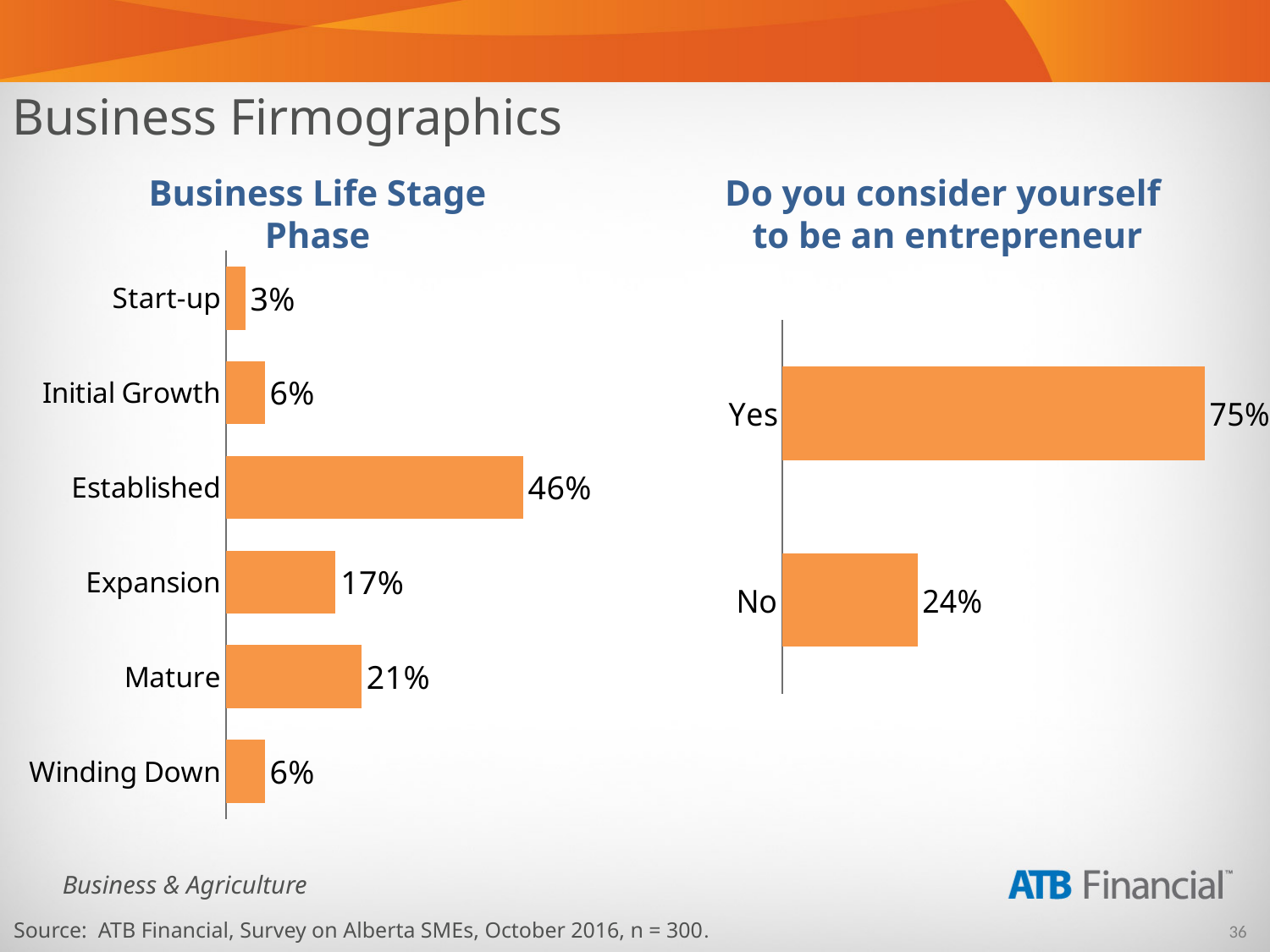
In the 'Business Life Stage Phase' chart, what is the value for Expansion? 17% In the 'Business Life Stage Phase' chart, which is larger, Initial Growth or Mature? Mature In the 'Business Life Stage Phase' chart, what is the difference between Mature and Expansion? 4% In the 'Do you consider yourself to be an entrepreneur' chart, what is the value for No? 24% How many categories are shown in the 'Business Life Stage Phase' chart? 6 What kind of chart is the 'Business Life Stage Phase' chart? Bar chart In the 'Do you consider yourself to be an entrepreneur' chart, what is the value for Yes? 75% How many categories are shown in the 'Do you consider yourself to be an entrepreneur' chart? 2 In the 'Business Life Stage Phase' chart, which category has the highest value? Established In the 'Business Life Stage Phase' chart, what is the value for Established? 46% In the 'Do you consider yourself to be an entrepreneur' chart, what is the difference between Yes and No? 51% In the 'Business Life Stage Phase' chart, which category has the lowest value? Start-up